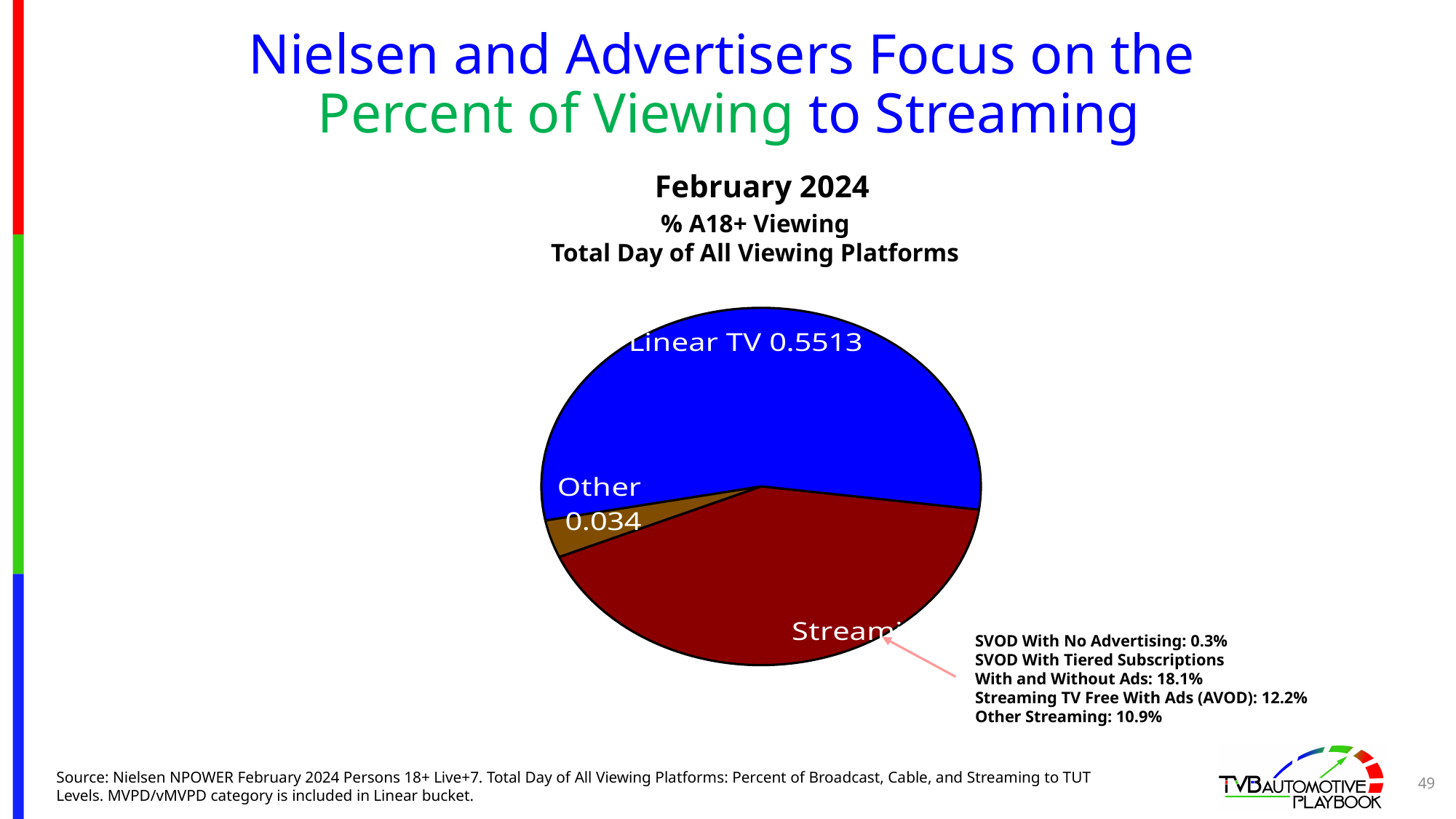
Which is larger in the pie chart, Linear TV or Streaming? Linear TV What month and year does the pie chart's title say the data is for? February 2024 What value is shown for Linear TV in the pie chart? 0.5513 What value is shown for Other in the pie chart? 0.034 What colour is the Streaming slice of the pie chart? dark red What is the difference between the Linear TV value and the Other value in the pie chart? 0.5173 Which slice of the pie chart is the largest? Linear TV How many slices does the pie chart have? 3 What kind of chart is shown on the slide? pie chart Which slice of the pie chart is the smallest? Other Which is larger in the pie chart, Streaming or Other? Streaming